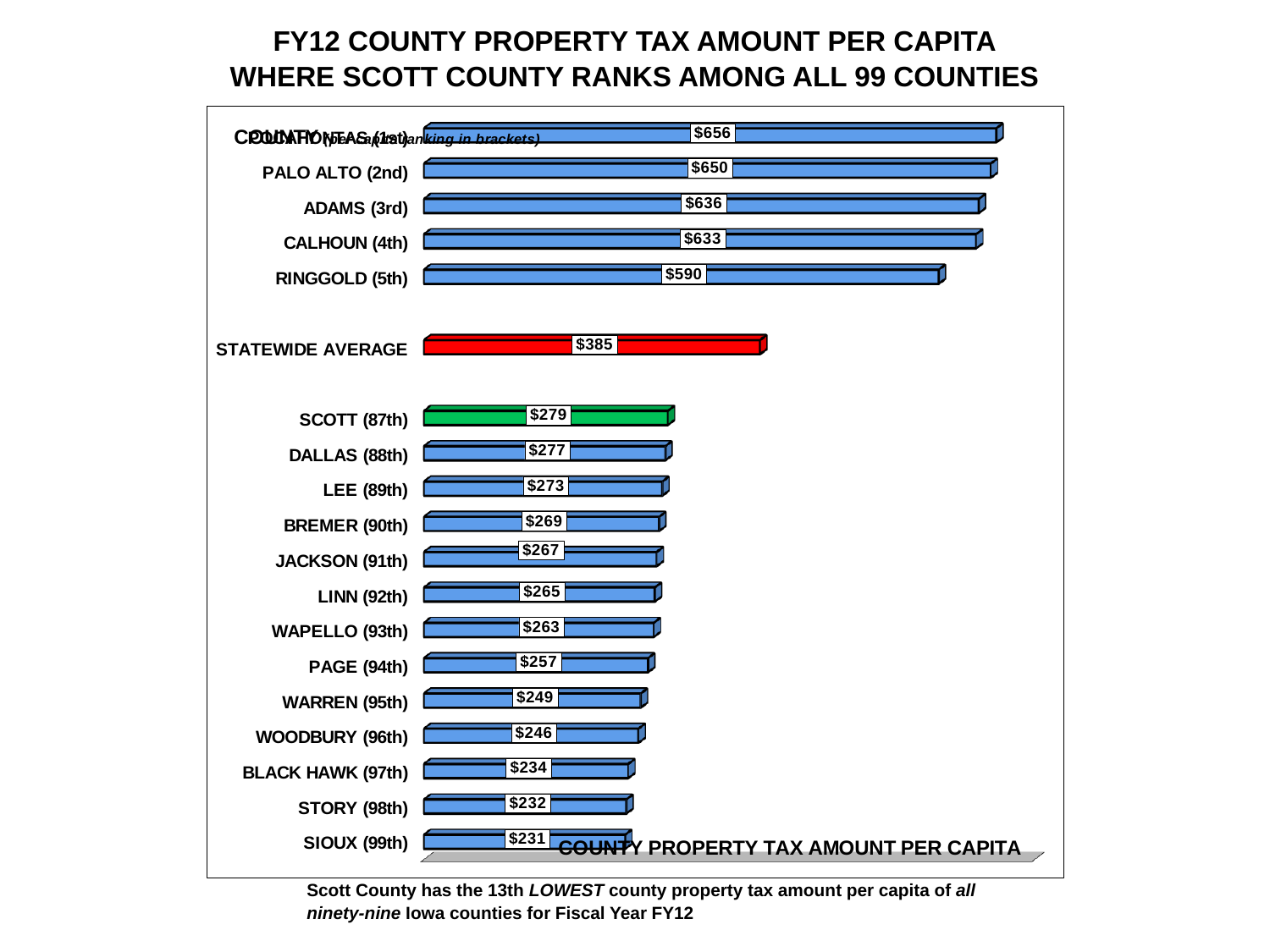
What is the value for BLACK HAWK (97th)? $234 What is the difference between PALO ALTO (2nd) and ADAMS (3rd)? $14 What is the county property tax amount per capita for SCOTT (87th)? $279 How much higher is the STATEWIDE AVERAGE than SCOTT (87th)? $106 What kind of chart is shown on the slide? Bar chart What is the value shown for the STATEWIDE AVERAGE bar? $385 Which category has the lowest county property tax amount per capita? SIOUX (99th) How many bars are plotted on the chart? 19 What colour is the bar for SCOTT (87th)? Green What is the value for PALO ALTO (2nd)? $650 Which is larger, the value for DALLAS (88th) or LEE (89th)? DALLAS (88th) What is the highest value shown on the chart? $656